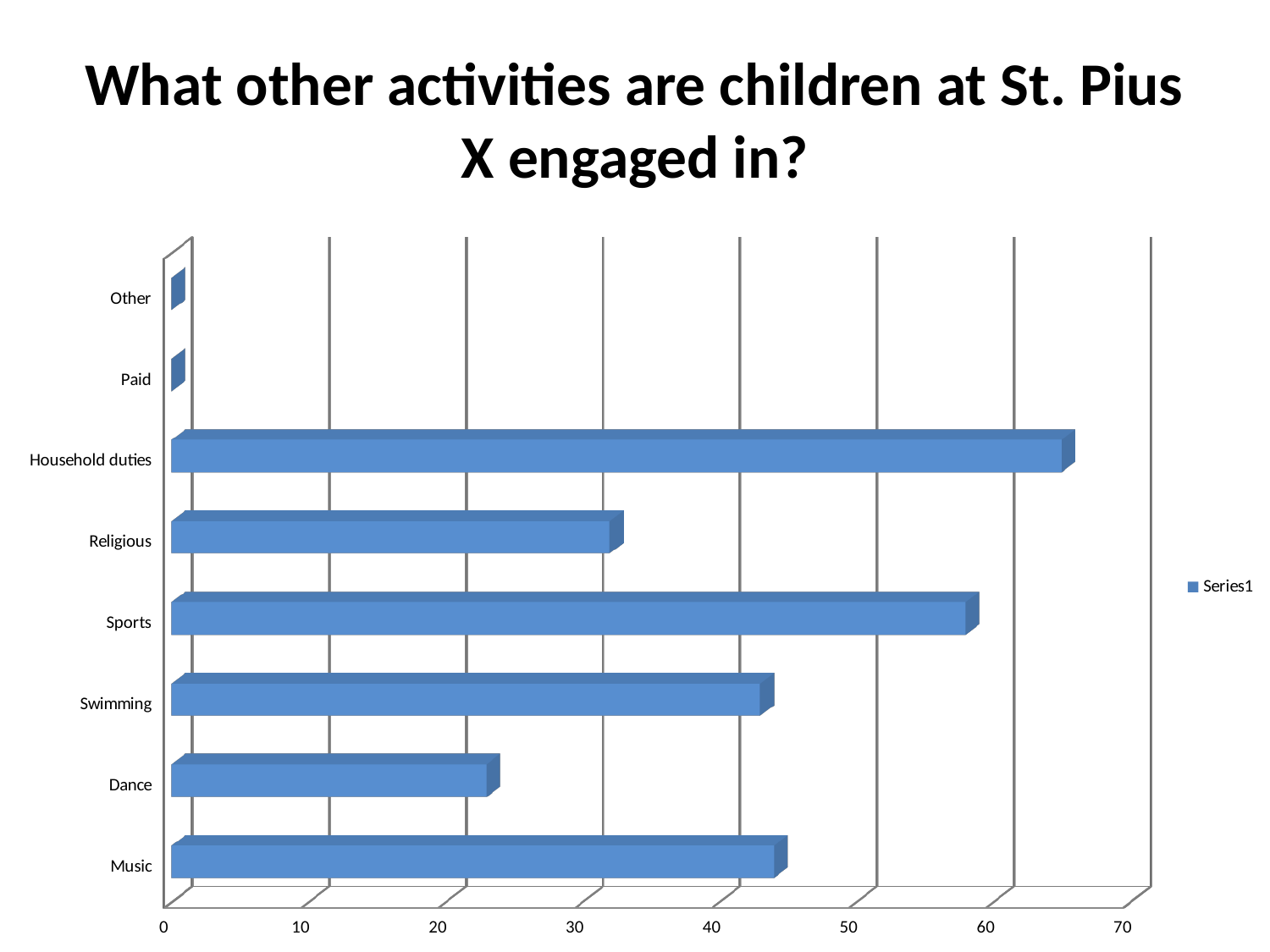
Which is larger, the value for Religious or the value for Dance? Religious How many series does the legend list? 1 Is the value for Sports greater or less than 50? greater Is the value for Swimming greater or less than 40? greater Is the value for Household duties greater or less than 60? greater Which is larger, the value for Household duties or the value for Sports? Household duties What is the name of the series shown in the legend? Series1 What kind of chart is shown on the slide? bar chart How many activity categories are plotted on the chart? 8 Which activity has the highest value on the chart? Household duties